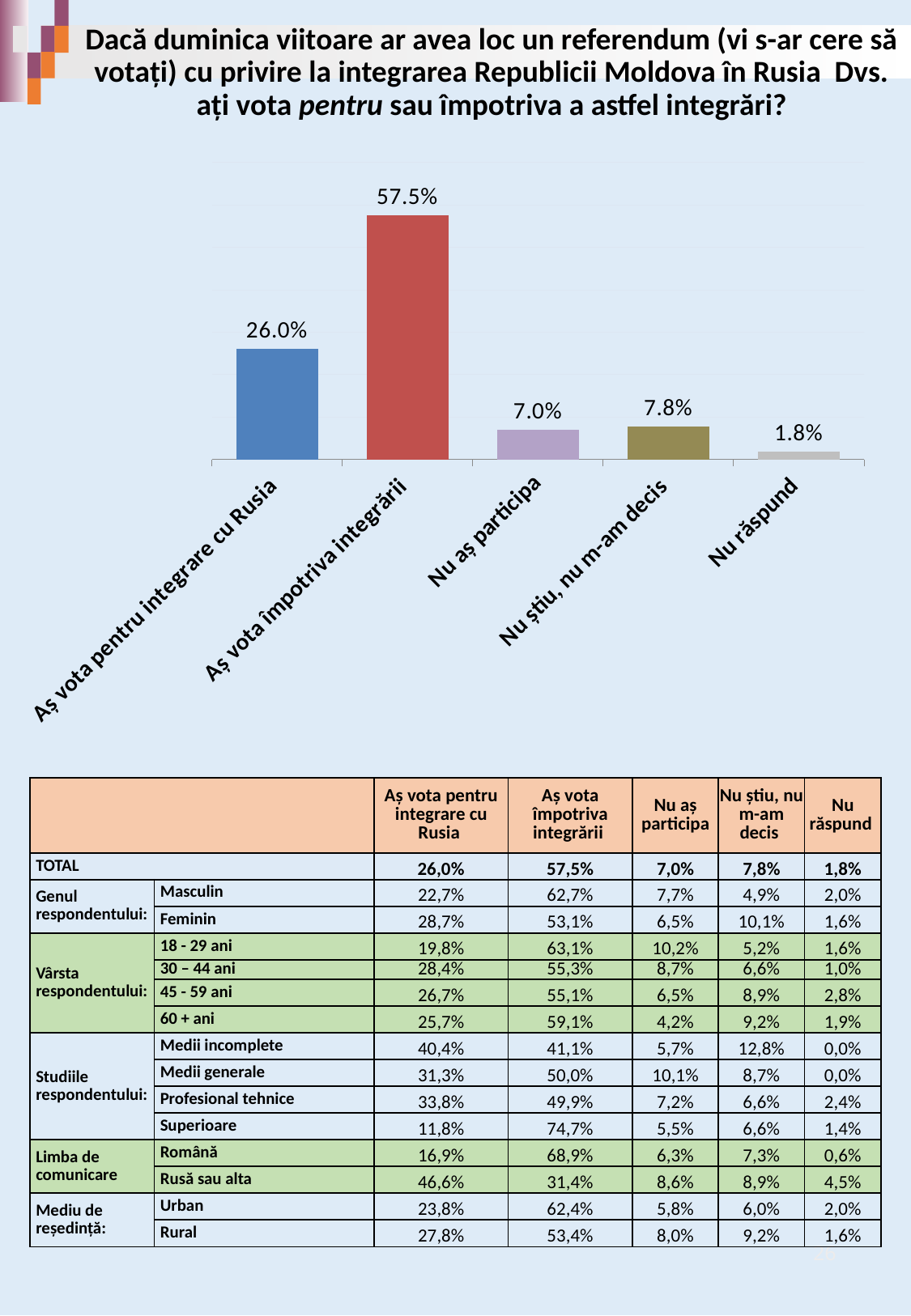
What percentage is shown for 'Nu aș participa'? 7.0% Which category has the highest value in the bar chart? Aș vota împotriva integrării Which category has the lowest value in the bar chart? Nu răspund How many categories are shown in the bar chart? 5 What is the difference between the values for 'Aș vota împotriva integrării' and 'Aș vota pentru integrare cu Rusia'? 31.5% What type of chart is shown on the slide? Bar chart What colour is the bar for 'Aș vota împotriva integrării'? Red What percentage of respondents said they would vote for integration with Russia (Aș vota pentru integrare cu Rusia)? 26.0% What is the difference between 'Nu știu, nu m-am decis' and 'Nu aș participa'? 0.8% What value does the bar for 'Nu răspund' show? 1.8% What value is shown for 'Aș vota împotriva integrării'? 57.5% Which is larger: the value for 'Nu știu, nu m-am decis' or the value for 'Nu aș participa'? Nu știu, nu m-am decis